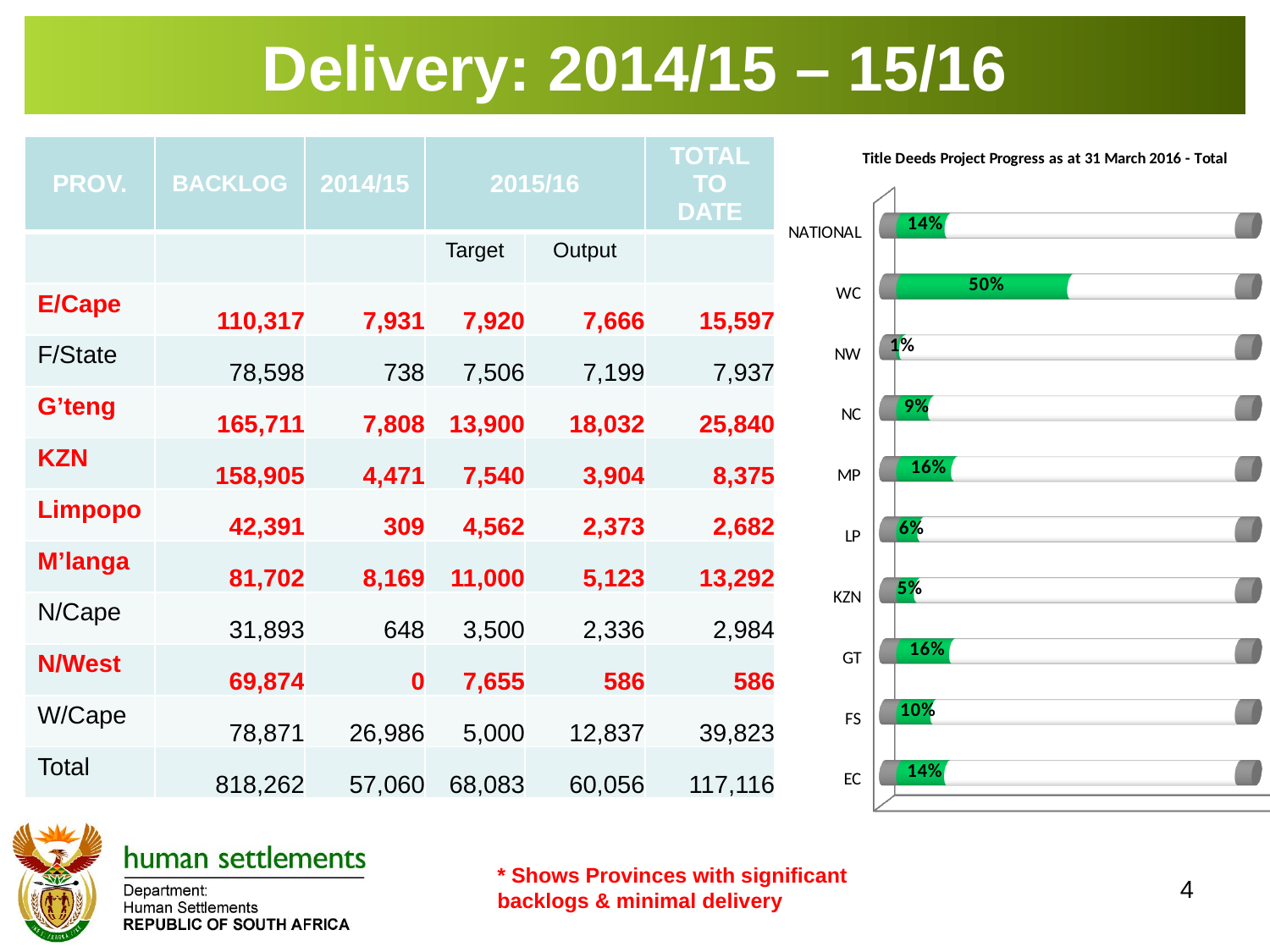
What is the value for WC in the Title Deeds Project Progress chart? 50% What is the value for FS in the Title Deeds Project Progress chart? 10% What is the value for MP in the Title Deeds Project Progress chart? 16% What is the difference between the values for WC and NATIONAL in the Title Deeds Project Progress chart? 36% What is the value for NATIONAL in the Title Deeds Project Progress chart? 14% Which category has the highest value in the Title Deeds Project Progress chart? WC How many categories are shown in the Title Deeds Project Progress chart? 10 What is the value for NW in the Title Deeds Project Progress chart? 1% What is the title of the chart on the slide? Title Deeds Project Progress as at 31 March 2016 - Total What kind of chart is the Title Deeds Project Progress chart? Bar chart Which category has the lowest value in the Title Deeds Project Progress chart? NW In the Title Deeds Project Progress chart, which is larger, the value for MP or the value for FS? MP